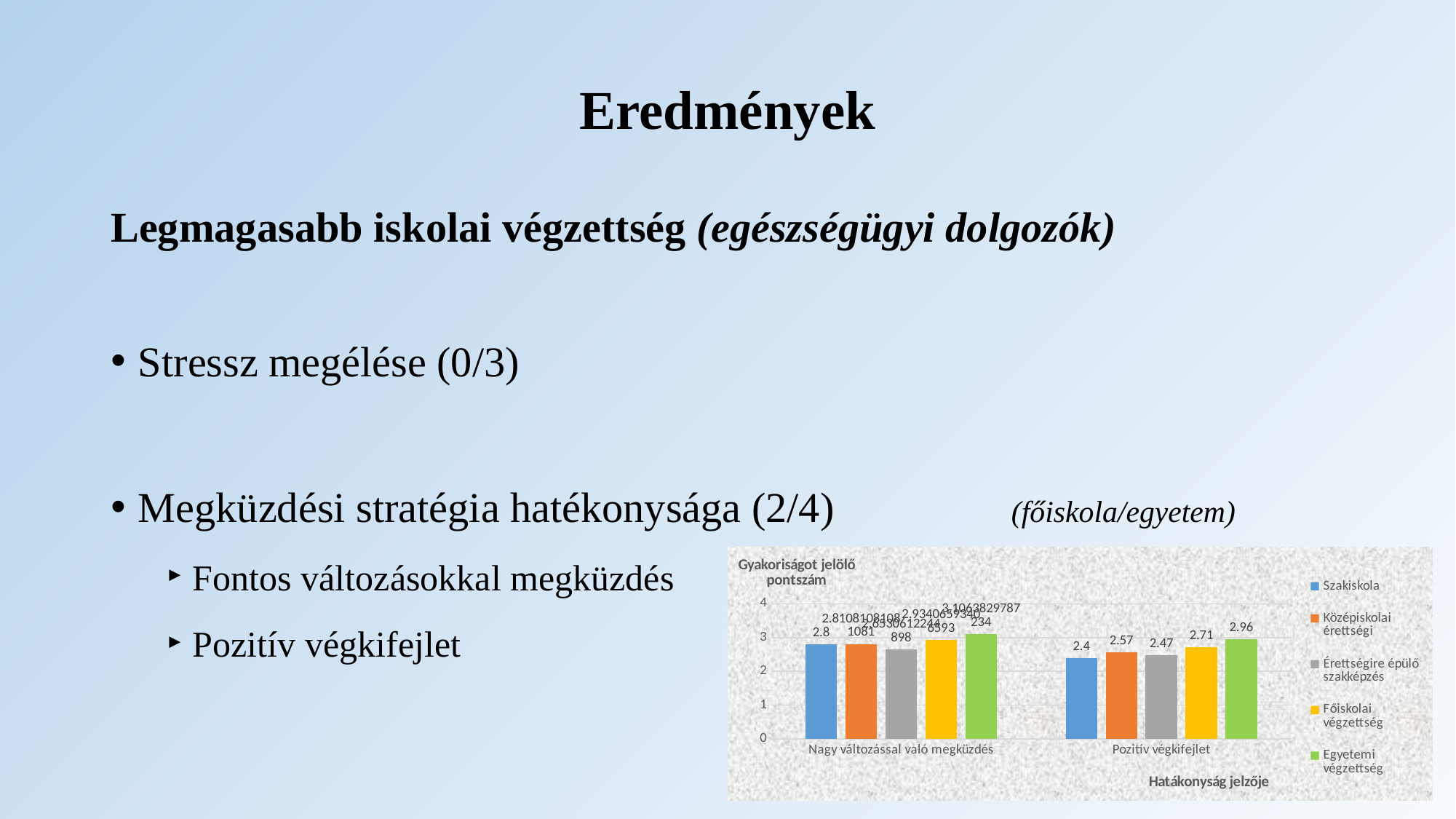
What is the value for Egyetemi végzettség in the Pozitív végkifejlet category? 2.96 What is the value for Szakiskola in the Nagy változással való megküzdés category? 2.8 What is the value for Főiskolai végzettség in the Pozitív végkifejlet category? 2.71 Which series has the lowest value in the Pozitív végkifejlet category? Szakiskola What kind of chart is shown on the slide? bar chart How many categories are shown on the x axis of the chart? 2 In the Pozitív végkifejlet category, which is larger: Főiskolai végzettség or Középiskolai érettségi? Főiskolai végzettség What is the value for Szakiskola in the Pozitív végkifejlet category? 2.4 How many series does the chart legend list? 5 Which series has the highest value in the Pozitív végkifejlet category? Egyetemi végzettség What is the difference between Egyetemi végzettség and Szakiskola in the Pozitív végkifejlet category? 0.56 Is the value for Érettségire épülő szakképzés in the Nagy változással való megküzdés category greater or less than 3? less